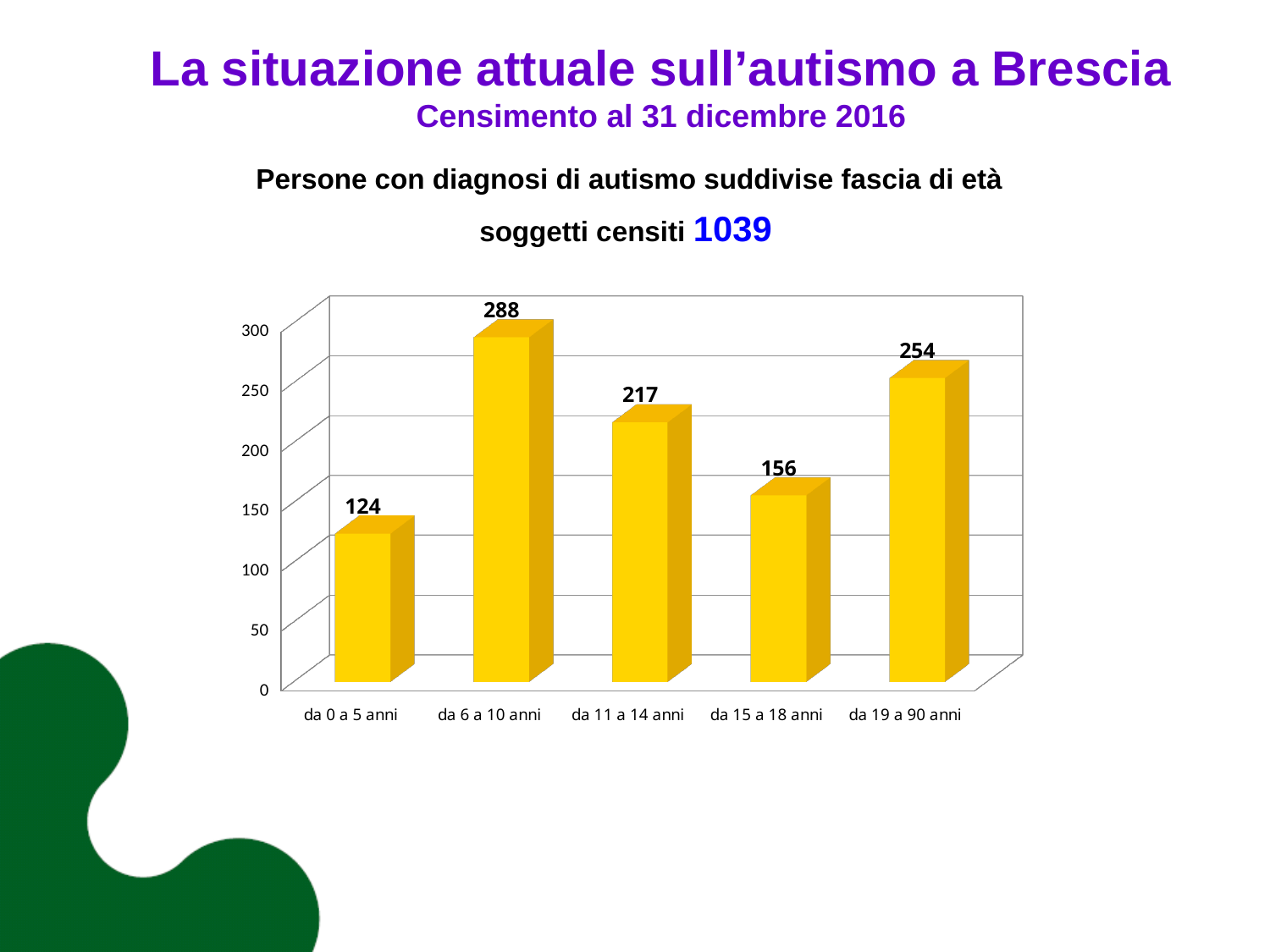
What is the value for the 'da 11 a 14 anni' age group? 217 What is the value for the 'da 15 a 18 anni' age group? 156 Which age group has the lowest value? da 0 a 5 anni Which age group has the highest value? da 6 a 10 anni What is the difference between the values for 'da 6 a 10 anni' and 'da 0 a 5 anni'? 164 What is the value for the 'da 19 a 90 anni' age group? 254 What is the value for the 'da 6 a 10 anni' age group? 288 Which is larger, the value for 'da 11 a 14 anni' or 'da 19 a 90 anni'? da 19 a 90 anni What is the value for the 'da 0 a 5 anni' age group? 124 What kind of chart is shown on the slide? Bar chart How many age groups are shown in the chart? 5 What is the total number of subjects counted ('soggetti censiti') stated on the slide? 1039